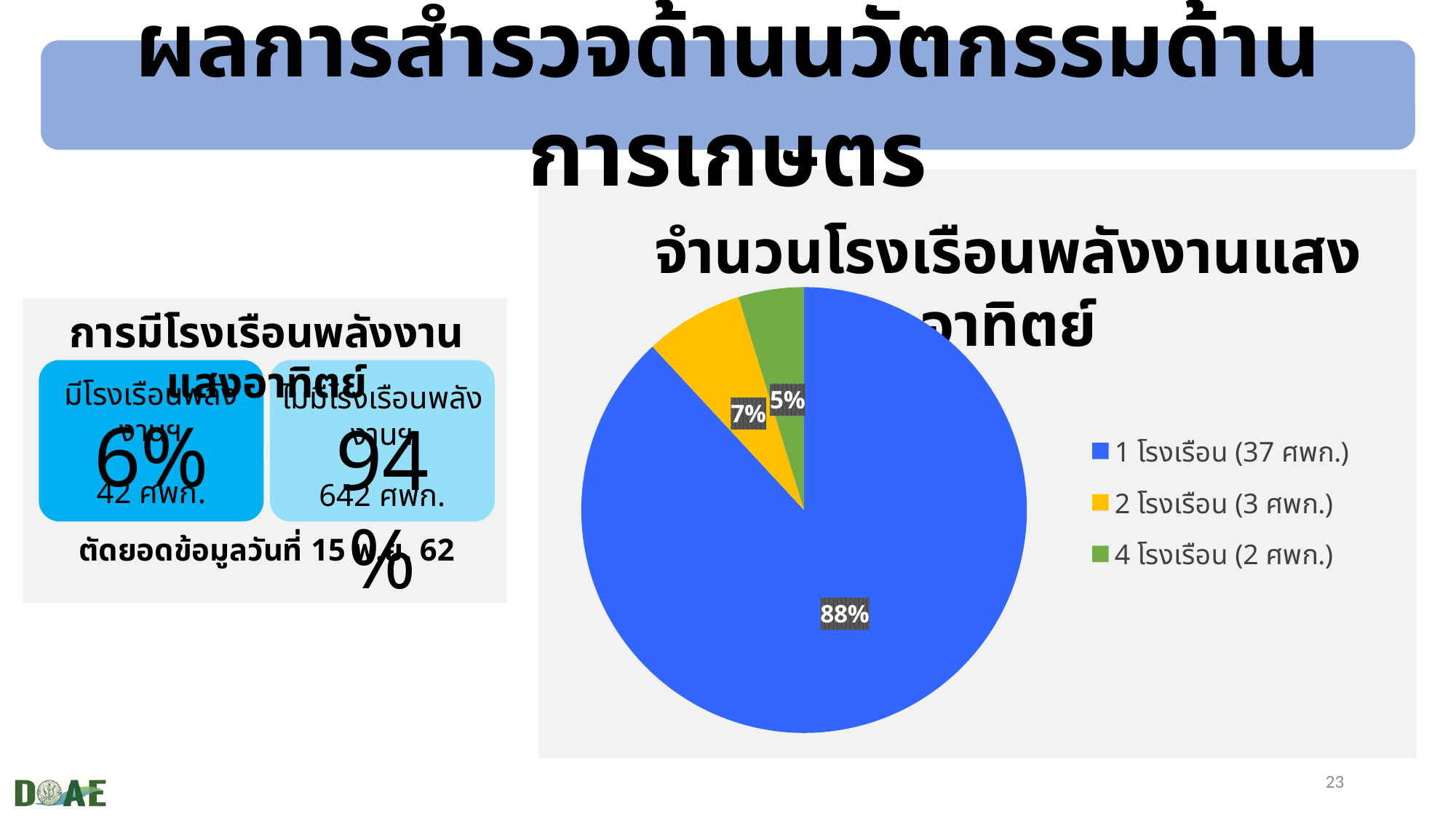
What share of the pie does the slice for 4 โรงเรือน (2 ศพก.) represent? 5% What share of the pie does the slice for 2 โรงเรือน (3 ศพก.) represent? 7% What kind of chart is shown on the slide? Pie chart Which category has the smallest slice of the pie? 4 โรงเรือน (2 ศพก.) Which category has the largest slice of the pie? 1 โรงเรือน (37 ศพก.) How many slices does the pie chart have? 3 How many entries does the legend of the pie chart list? 3 What colour is the slice for 2 โรงเรือน (3 ศพก.) in the pie chart? Yellow What is the difference in percentage points between the slice for 1 โรงเรือน and the slice for 2 โรงเรือน? 81 What is the title of the pie chart? จำนวนโรงเรือนพลังงานแสงอาทิตย์ Which slice is larger: 2 โรงเรือน (3 ศพก.) or 4 โรงเรือน (2 ศพก.)? 2 โรงเรือน (3 ศพก.) What share of the pie does the slice for 1 โรงเรือน (37 ศพก.) represent? 88%